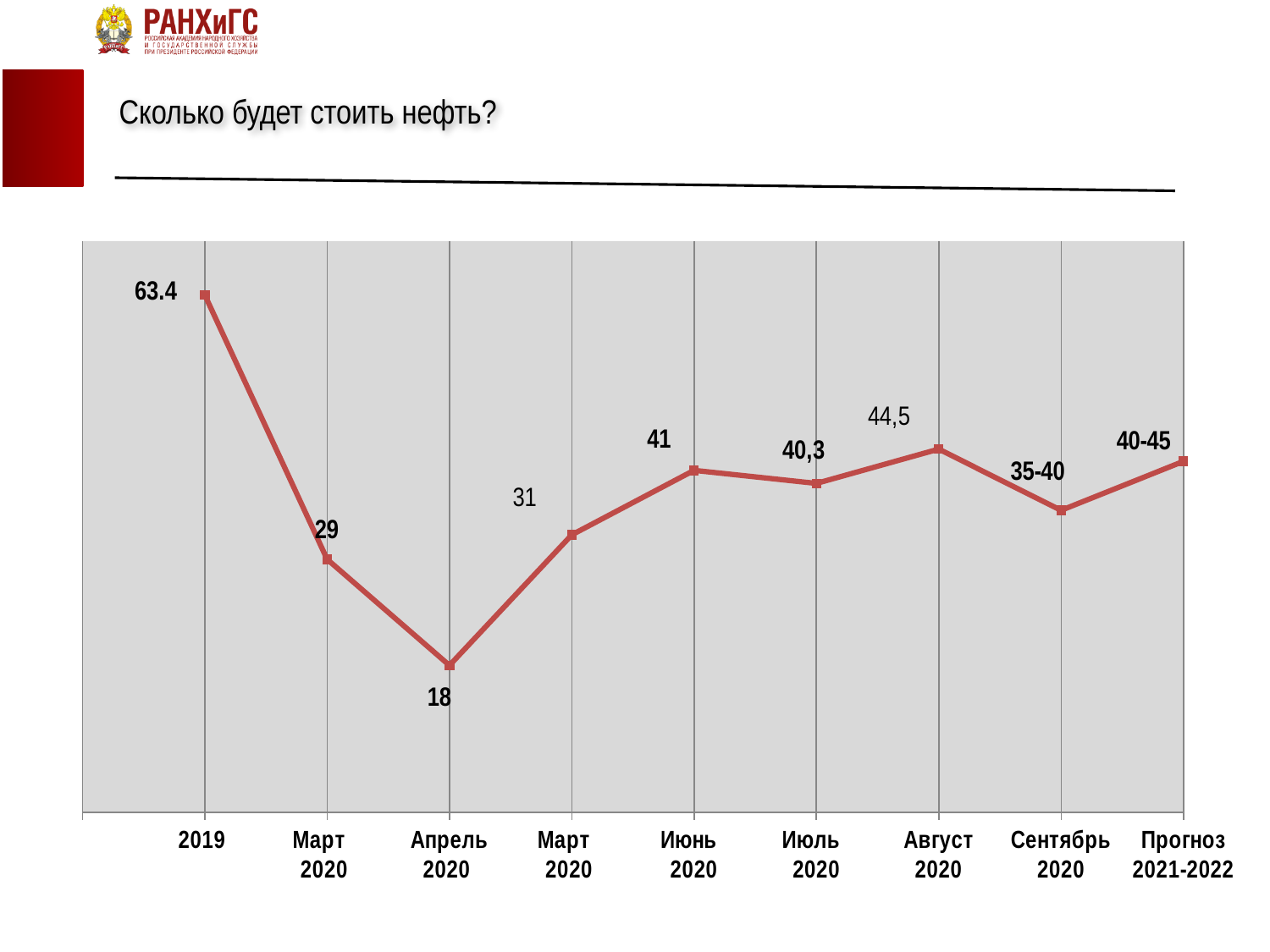
What type of chart is shown on the slide? line chart Which category has the highest value? 2019 What is the difference between the value for 2019 and the value for Апрель 2020? 45.4 What is the value for Август 2020? 44,5 What is the value shown for Сентябрь 2020? 35-40 What is the value shown for Прогноз 2021-2022? 40-45 How many data points are plotted on the chart? 9 Which category has the lowest value? Апрель 2020 What is the value for Июль 2020? 40,3 What is the value for 2019? 63.4 What is the value for Апрель 2020? 18 What is the title of the slide with the chart? Сколько будет стоить нефть?